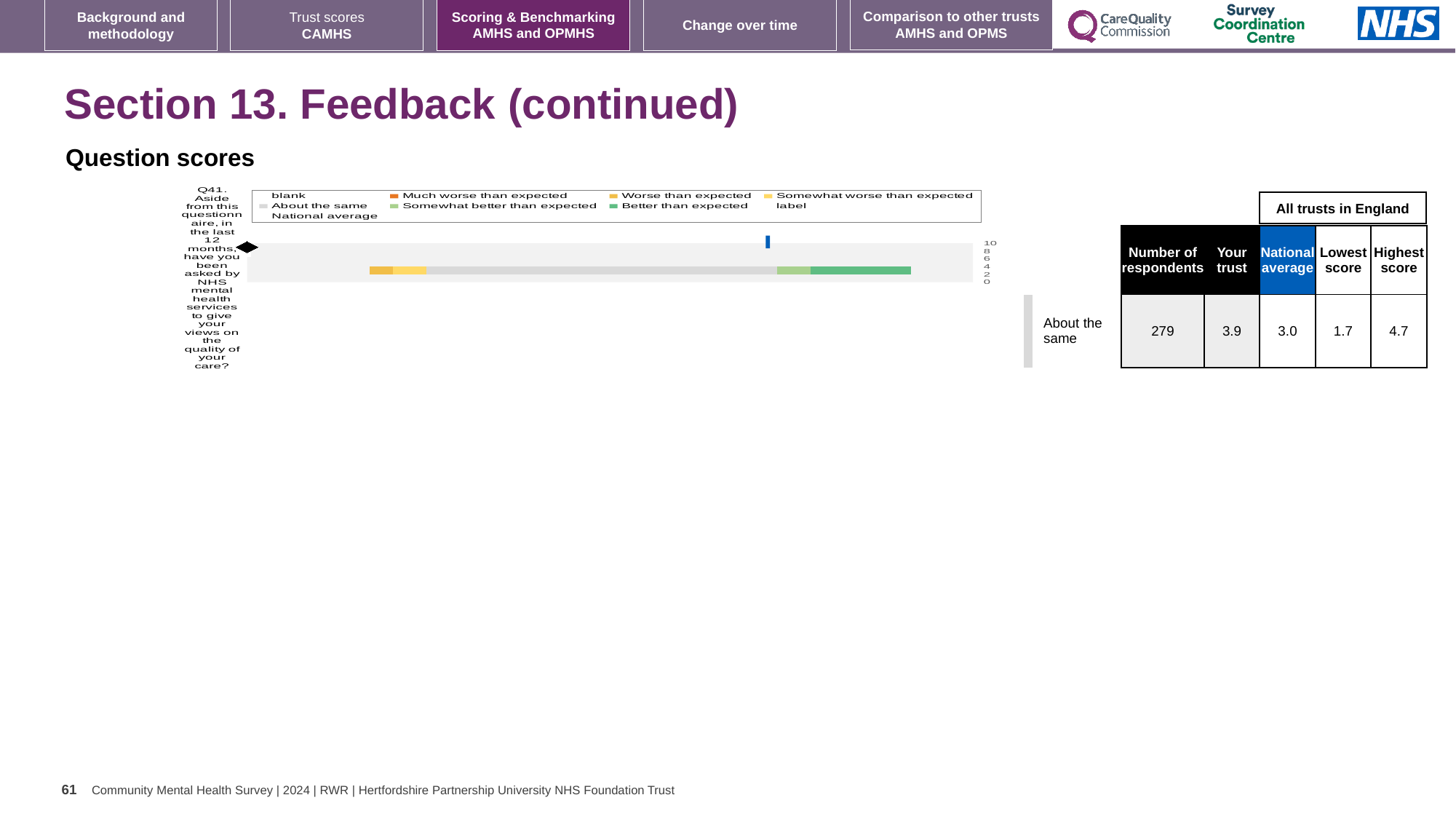
How many entries does the chart's legend list? 9 In the table beside the chart, how many respondents answered Q41? 279 Which is larger for Q41: the 'Your trust' score or the national average? Your trust What benchmark category is given for Q41 next to the chart? About the same In the table beside the chart, what is the national average score for Q41? 3.0 What kind of chart is shown on the slide? bar chart In the table beside the chart, what is the 'Your trust' score for Q41? 3.9 Which question number is plotted in the chart? Q41 How many survey questions are plotted in the chart? 1 What is the difference between the highest score (4.7) and the lowest score (1.7) for Q41? 3.0 What colour is the 'Better than expected' segment in the chart? green What is the highest value shown on the chart's axis? 10